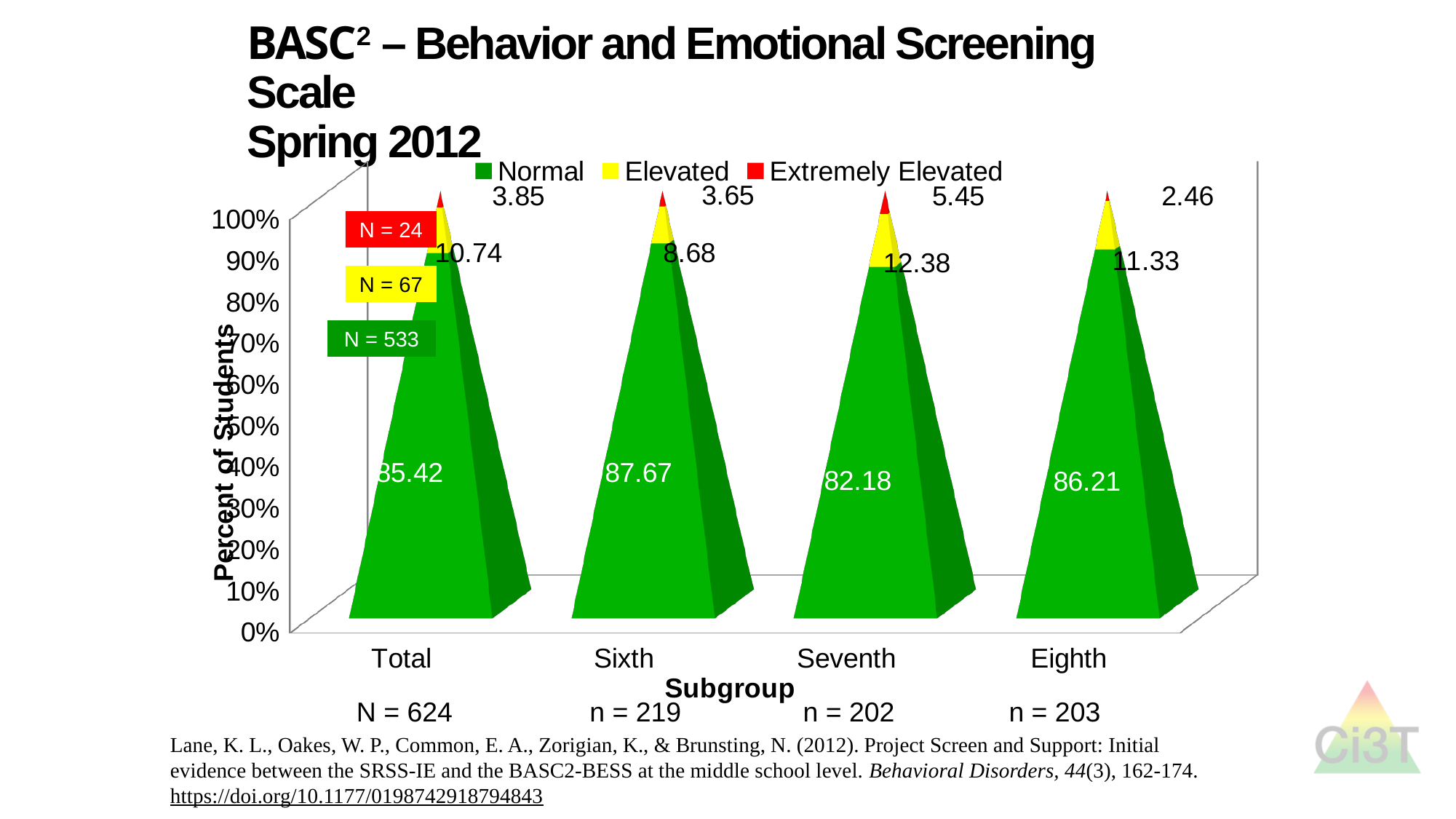
How many subgroups are shown on the x axis? 4 What is the Normal value for the Sixth subgroup? 87.67 Which is larger, the Elevated value for Sixth or for Eighth? Eighth Which subgroup has the highest Normal value? Sixth What is the Elevated value for the Seventh subgroup? 12.38 Which subgroup has the lowest Normal value? Seventh Which subgroup has the highest Extremely Elevated value? Seventh How many series does the legend list? 3 What is the Normal value for the Total subgroup? 85.42 What is the Extremely Elevated value for the Eighth subgroup? 2.46 What kind of chart is shown? Stacked bar chart What is the difference between the Normal values for Sixth and Seventh? 5.49